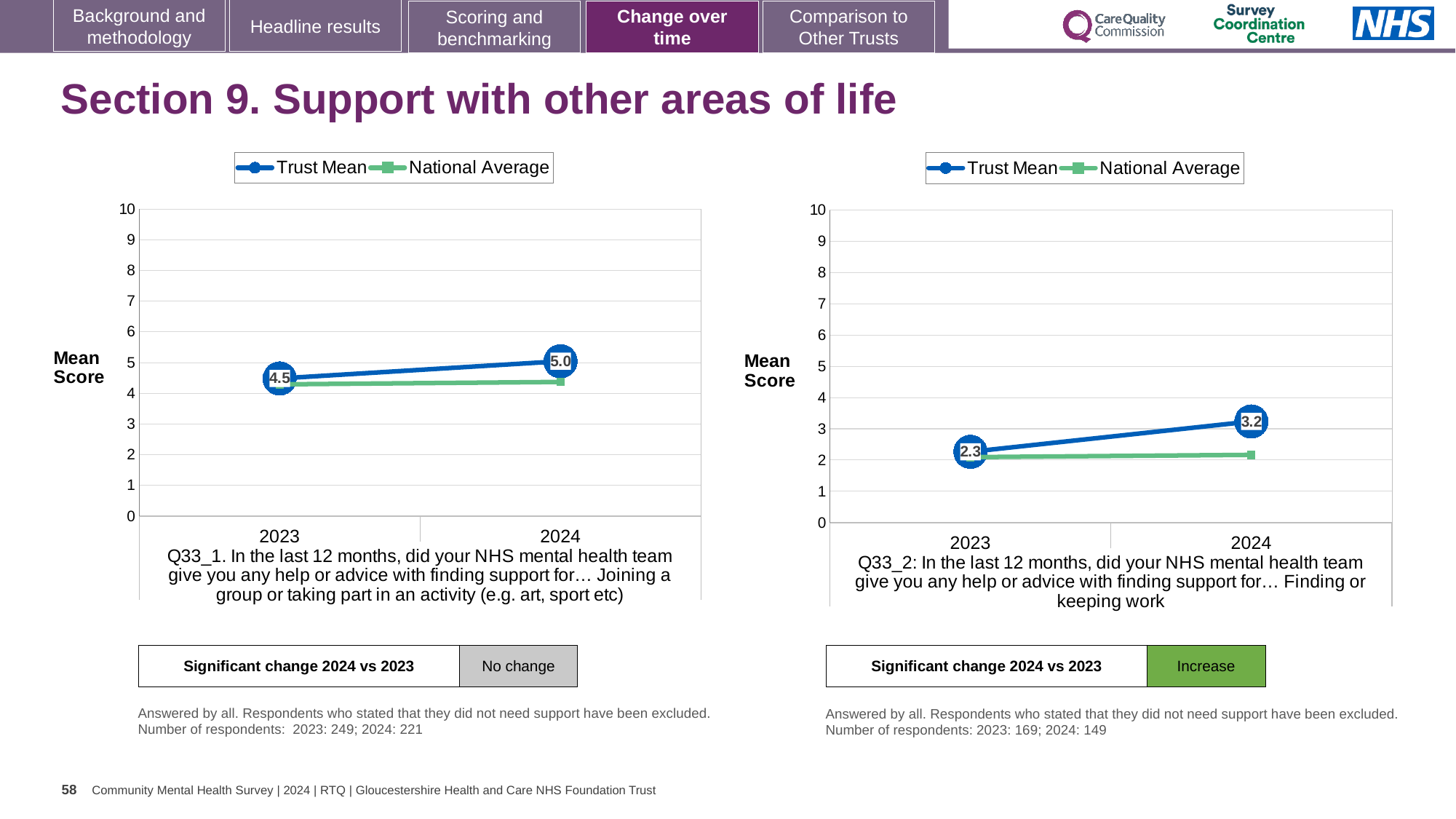
What kind of chart is the left chart (Q33_1)? line chart In the right chart (Q33_2), what is the difference between the Trust Mean in 2024 and in 2023? 0.9 In the right chart (Q33_2), is the National Average for 2024 greater or less than 3? less In the left chart (Q33_1), what is the Trust Mean for 2024? 5.0 How many series does the legend of the right chart (Q33_2) list? 2 In the right chart (Q33_2), does the Trust Mean rise or fall from 2023 to 2024? rise In the left chart (Q33_1), what is the Trust Mean for 2023? 4.5 In the right chart (Q33_2), what is the Trust Mean for 2024? 3.2 In the left chart (Q33_1), which year has the higher Trust Mean, 2023 or 2024? 2024 In the right chart (Q33_2), what is the Trust Mean for 2023? 2.3 What does the 'Significant change 2024 vs 2023' box below the right chart (Q33_2) say? Increase In the left chart (Q33_1), by how much did the Trust Mean change from 2023 to 2024? 0.5